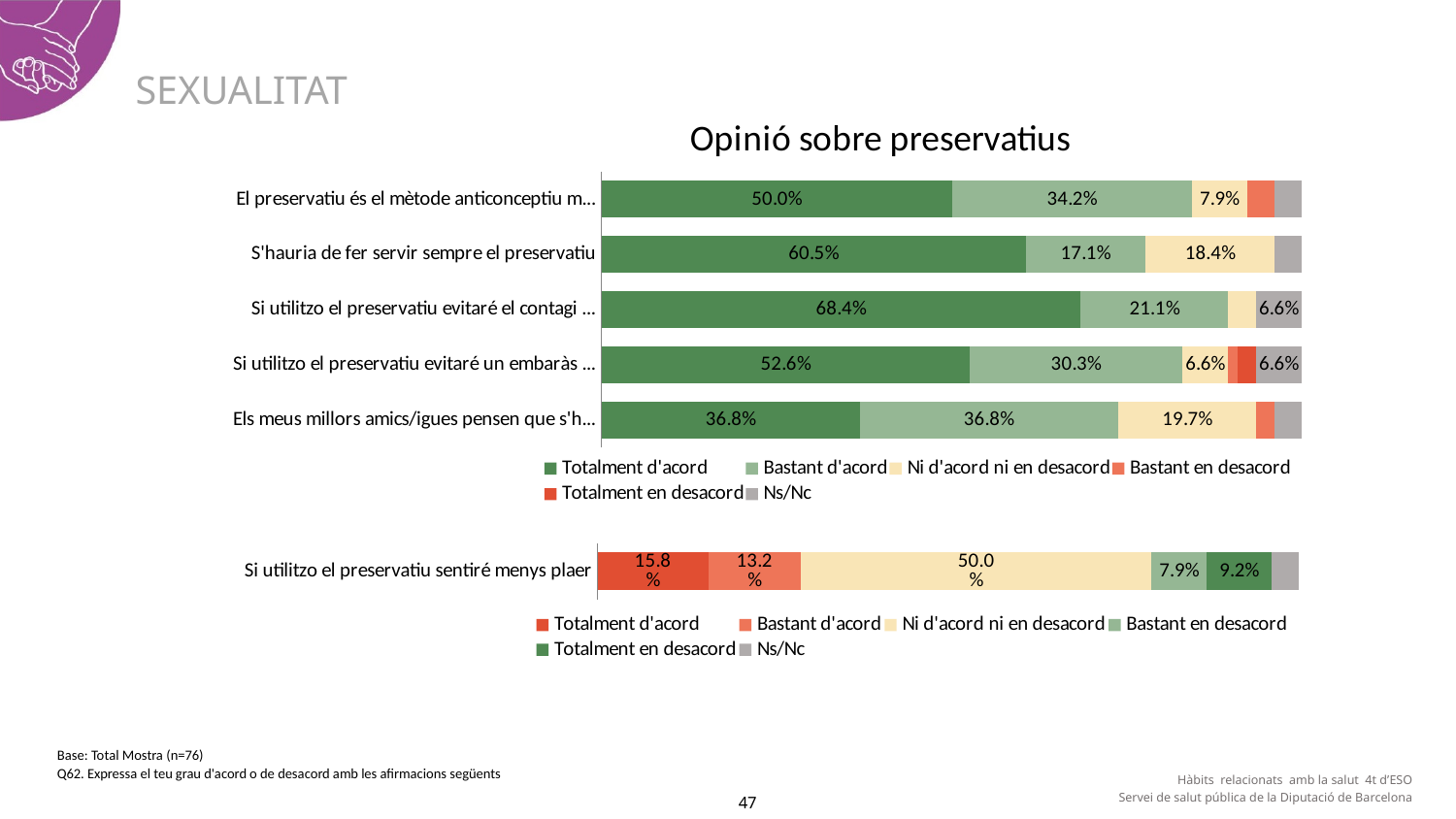
In the top chart 'Opinió sobre preservatius', what is the 'Bastant d'acord' value for 'Si utilitzo el preservatiu evitaré un embaràs ...'? 30.3% In the bottom chart, what percentage answered 'Ni d'acord ni en desacord' for 'Si utilitzo el preservatiu sentiré menys plaer'? 50.0% In the top chart 'Opinió sobre preservatius', what is the 'Ni d'acord ni en desacord' value for 'El preservatiu és el mètode anticonceptiu m...'? 7.9% How many statements are plotted in the top chart 'Opinió sobre preservatius'? 5 What type of chart is the top chart 'Opinió sobre preservatius'? Stacked bar chart In the top chart 'Opinió sobre preservatius', which has the larger 'Ni d'acord ni en desacord' value: 'S'hauria de fer servir sempre el preservatiu' or 'Els meus millors amics/igues pensen que s'h...'? Els meus millors amics/igues pensen que s'h... In the top chart 'Opinió sobre preservatius', what percentage answered 'Totalment d'acord' for 'S'hauria de fer servir sempre el preservatiu'? 60.5% How many series does the legend of the top chart 'Opinió sobre preservatius' list? 6 In the bottom chart, what percentage answered 'Totalment en desacord' for 'Si utilitzo el preservatiu sentiré menys plaer'? 9.2% In the top chart 'Opinió sobre preservatius', which statement has the highest 'Totalment d'acord' percentage? Si utilitzo el preservatiu evitaré el contagi ... In the top chart 'Opinió sobre preservatius', what is the difference in 'Totalment d'acord' between 'S'hauria de fer servir sempre el preservatiu' and 'El preservatiu és el mètode anticonceptiu m...'? 10.5 percentage points In the top chart 'Opinió sobre preservatius', which statement has the lowest 'Totalment d'acord' percentage? Els meus millors amics/igues pensen que s'h...